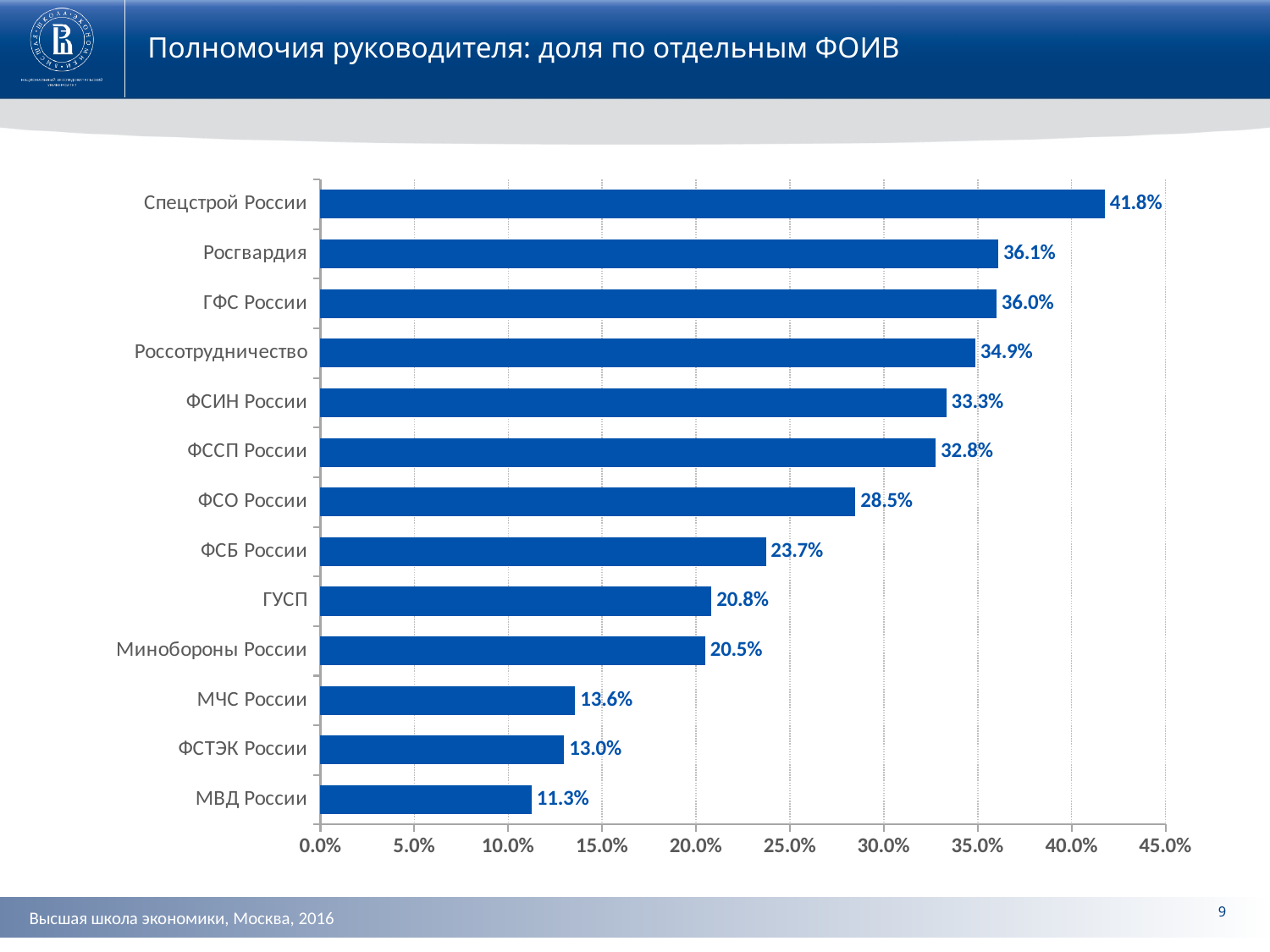
What kind of chart is shown on the slide? bar chart Which category has the lowest value? МВД России What is the title of the slide? Полномочия руководителя: доля по отдельным ФОИВ What is the value for Спецстрой России? 41.8% What is the value for ФСО России? 28.5% What is the value for МЧС России? 13.6% Which is larger, the value for ФСБ России or the value for ГУСП? ФСБ России How many categories are shown in the chart? 13 Is the value for Россотрудничество greater or less than 30.0%? greater Which category has the highest value? Спецстрой России What is the difference between the values for Спецстрой России and МВД России? 30.5% What is the difference between the values for ФСИН России and ФССП России? 0.5%